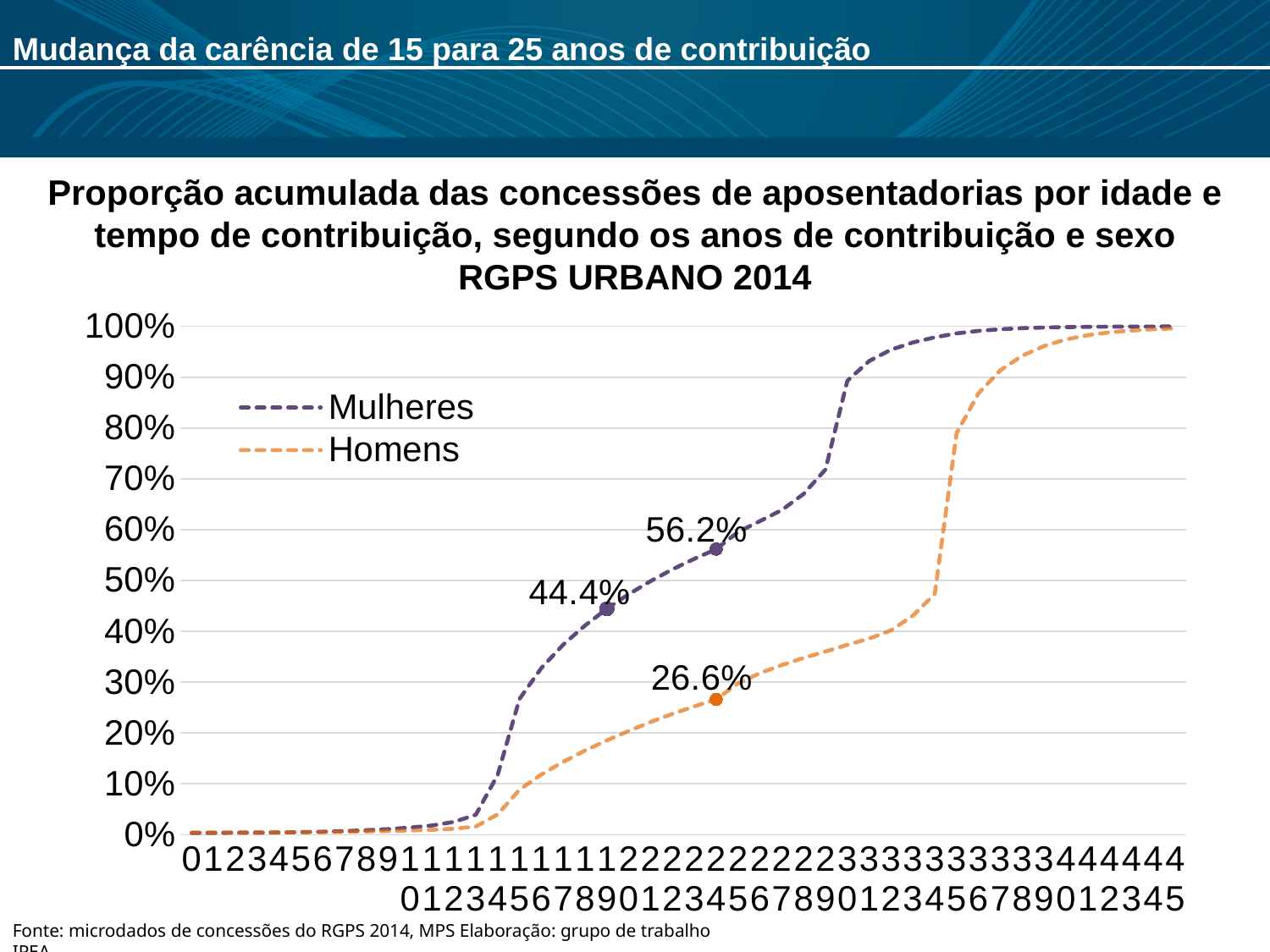
What is the difference between the 56.2% label on the Mulheres line and the 26.6% label on the Homens line? 29.6 percentage points What are the two series named in the legend? Mulheres and Homens Which series reaches 50% first along the x axis, Mulheres or Homens? Mulheres How many series does the legend list? 2 What kind of chart is shown on the slide? line chart What is the labeled value on the Homens line? 26.6% What is the highest labeled value on the Mulheres line? 56.2% Do the values of both lines rise or fall as the years of contribution increase along the x axis? rise What is the lower of the two labeled values on the Mulheres line? 44.4% Is the value of the Mulheres line at 10 years of contribution greater or less than 10%? less What is the difference between the two labeled values on the Mulheres line, 56.2% and 44.4%? 11.8 percentage points Is the value of the Homens line at 40 years of contribution greater or less than 90%? greater